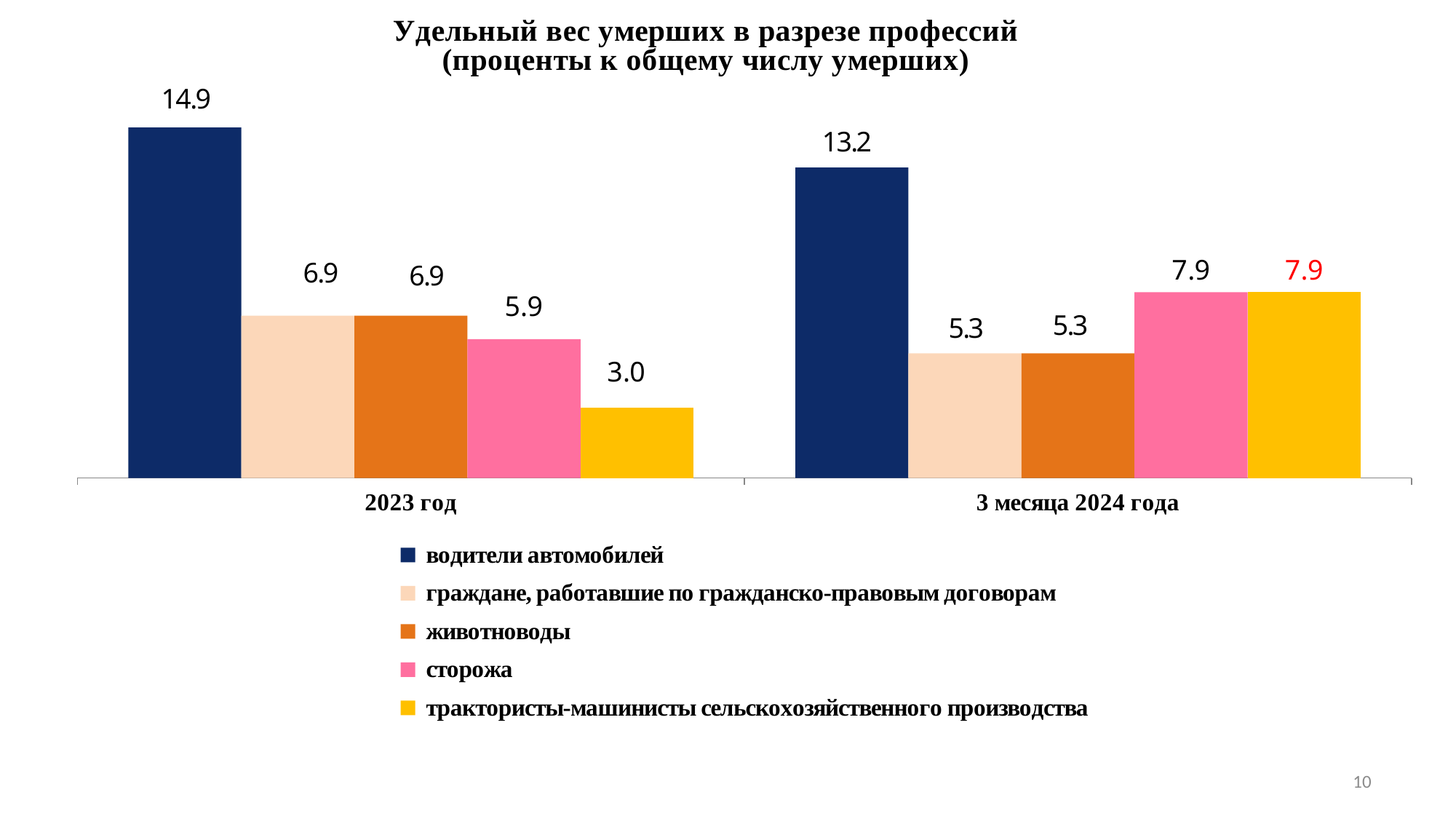
What is the value for животноводы in 3 месяца 2024 года? 5.3 What is the value for сторожа in 2023 год? 5.9 What kind of chart is shown on the slide? bar chart What is the value for трактористы-машинисты сельскохозяйственного производства in 3 месяца 2024 года? 7.9 How many series does the legend list? 5 Which series has the highest value in 2023 год? водители автомобилей What is the value for водители автомобилей in 2023 год? 14.9 What is the difference between the values for водители автомобилей in 2023 год and in 3 месяца 2024 года? 1.7 Which data label is shown in red? 7.9 for трактористы-машинисты сельскохозяйственного производства in 3 месяца 2024 года Which is larger: the value for сторожа in 2023 год or in 3 месяца 2024 года? 3 месяца 2024 года What is the difference between the values for трактористы-машинисты сельскохозяйственного производства in 3 месяца 2024 года and in 2023 год? 4.9 Which series has the lowest value in 2023 год? трактористы-машинисты сельскохозяйственного производства